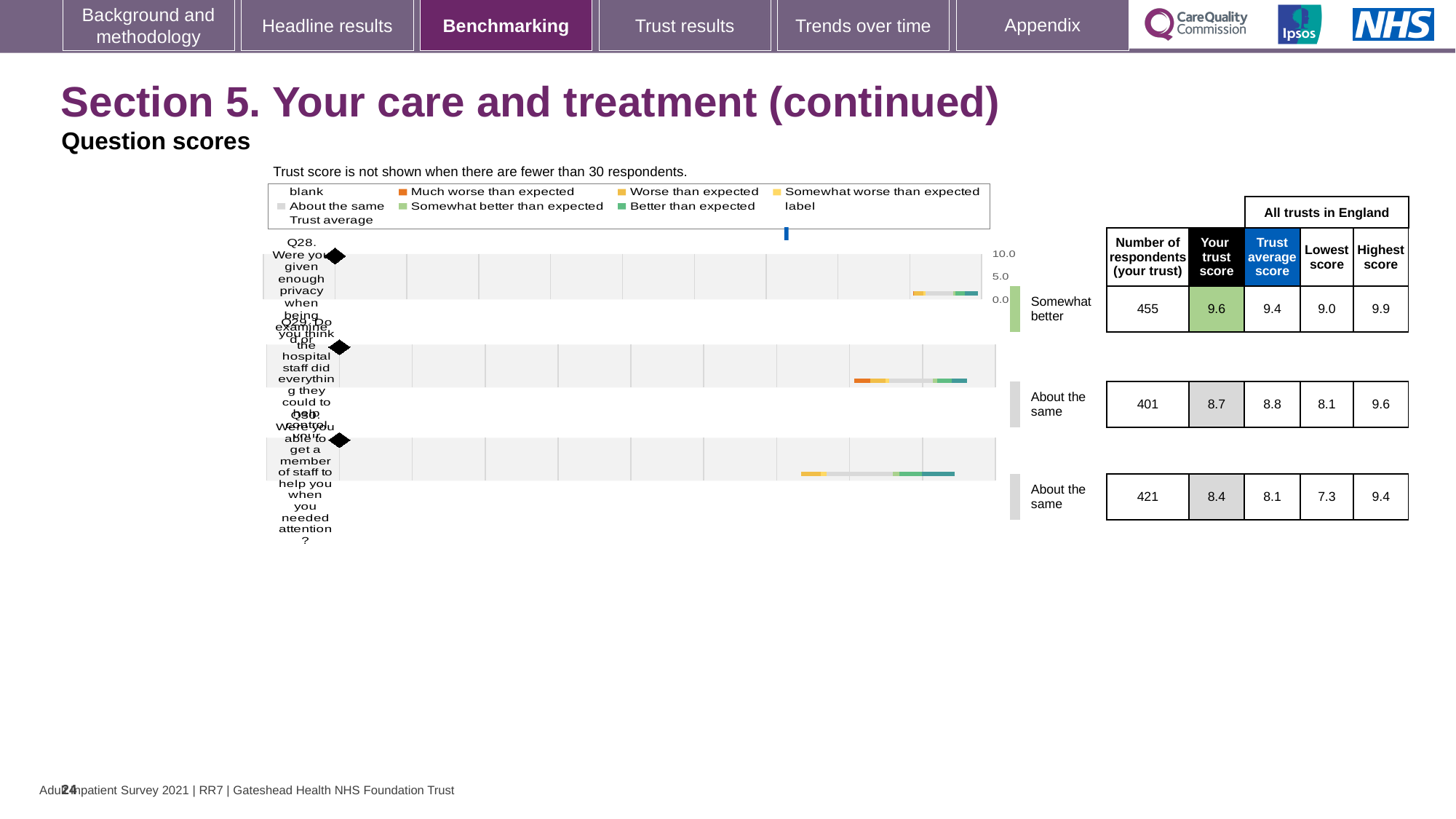
Which question has the highest trust score on this slide? Q28 For Q29, which is larger: the trust score or the trust average score? Trust average score Which question has the lowest trust score on this slide? Q30 What kind of chart is used to show the question scores? Bar chart By how much does the trust score for Q28 exceed the trust average score for Q28? 0.2 What benchmark category is shown for Q28? Somewhat better What is the trust score for Q28 (Were you given enough privacy when being examined or treated)? 9.6 How many respondents from the trust answered Q29? 401 What is the difference between the highest score and the lowest score for Q30? 2.1 How many questions are plotted on this slide? 3 What is the lowest score across all trusts in England for Q30? 7.3 What is the highest score across all trusts in England for Q30? 9.4